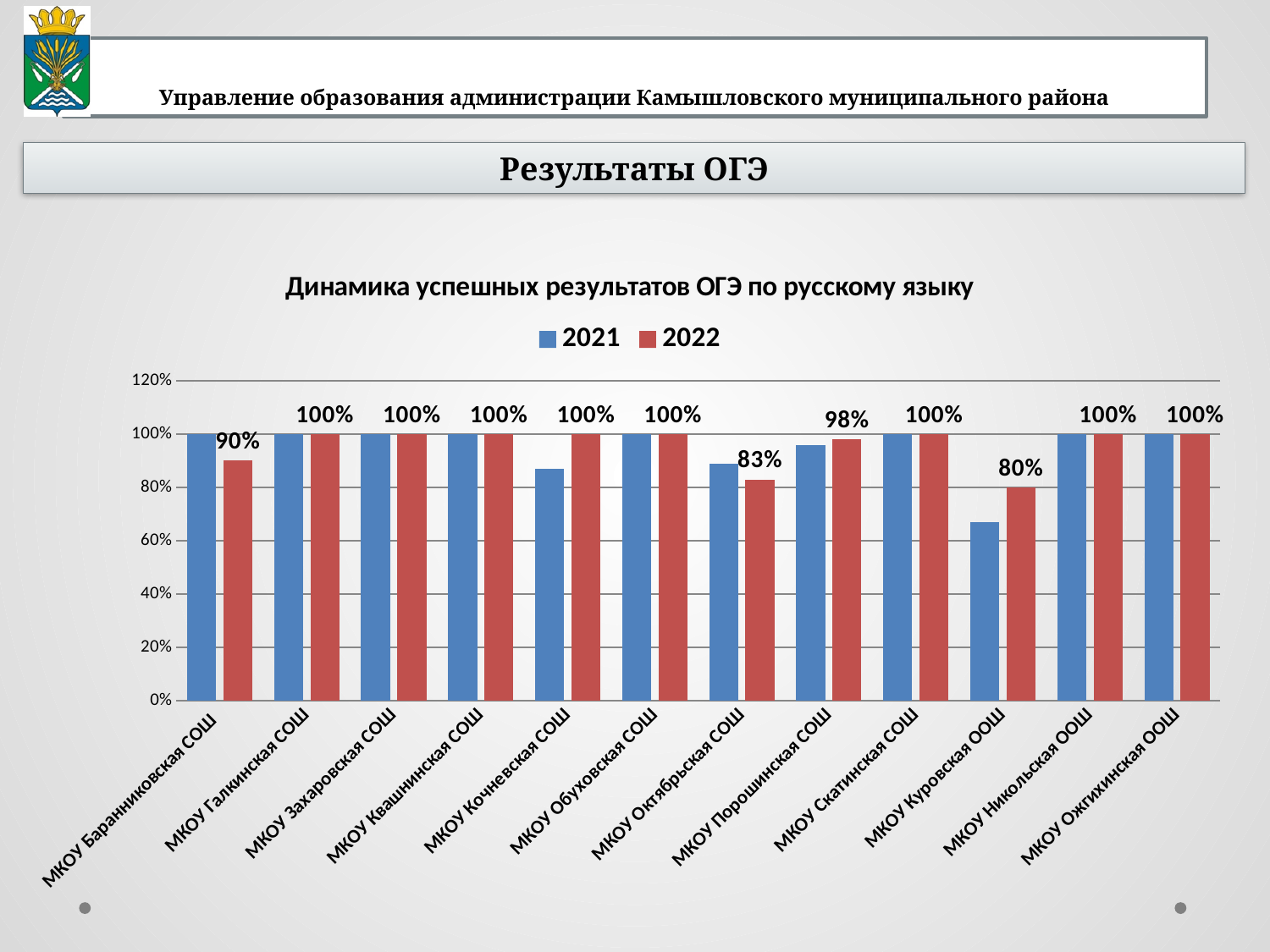
What is the difference between the 2022 values for МКОУ Баранниковская СОШ and МКОУ Куровская ООШ? 10% What is the 2022 value for МКОУ Порошинская СОШ? 98% Which school has the lowest 2022 value? МКОУ Куровская ООШ What is the 2022 value for МКОУ Октябрьская СОШ? 83% Is the 2021 value for МКОУ Кочневская СОШ greater or less than 80%? greater What is the 2022 value for МКОУ Баранниковская СОШ? 90% What kind of chart is this? Bar chart What is the 2022 value for МКОУ Куровская ООШ? 80% How many series does the legend list? 2 Is the 2021 value for МКОУ Куровская ООШ greater or less than 80%? less For МКОУ Куровская ООШ, which year has the larger value, 2021 or 2022? 2022 How many schools are shown on the x axis? 12